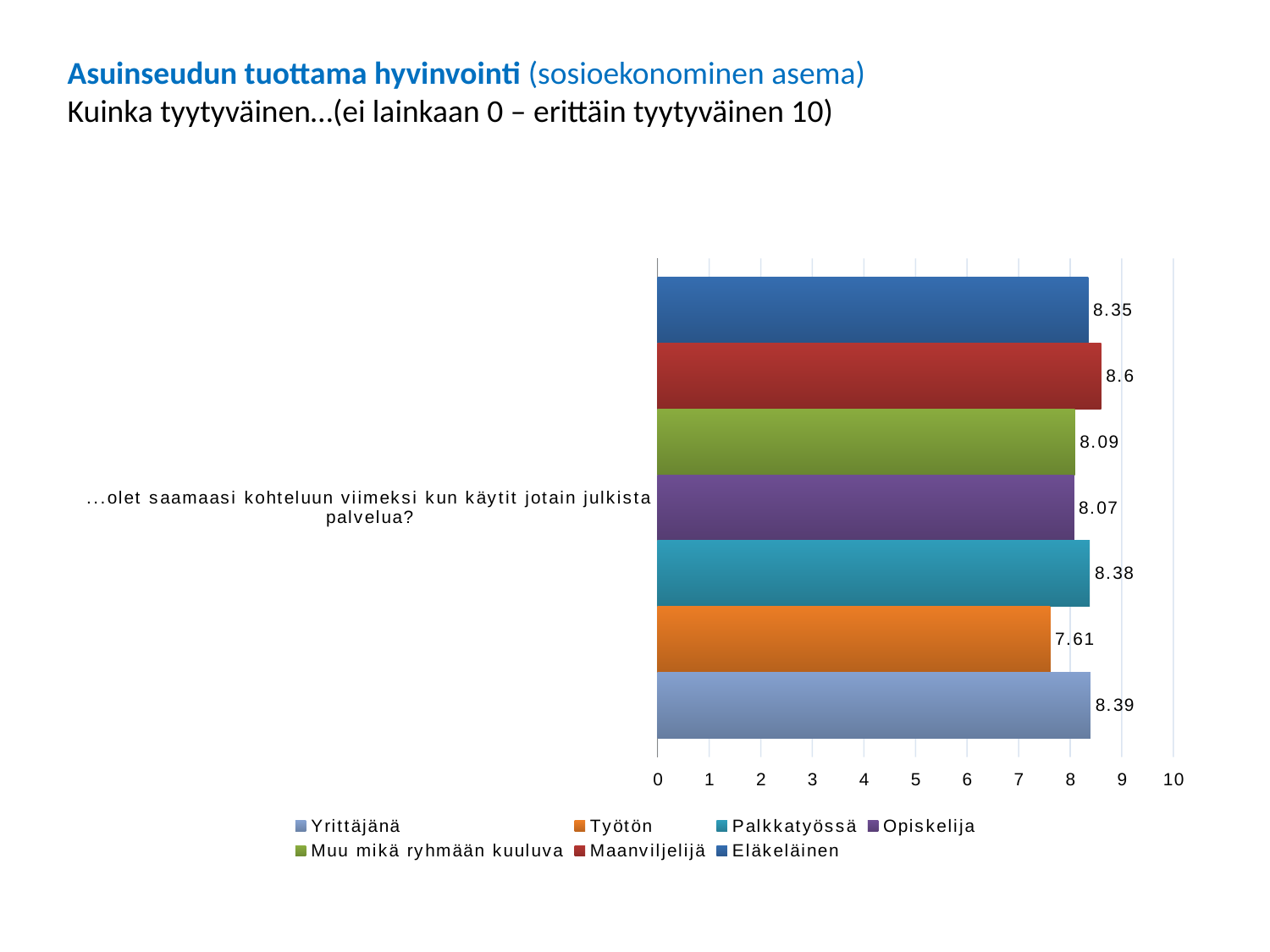
What is the value for Maanviljelijä? 8.6 What is the value for Työtön? 7.61 What is the value for Opiskelija? 8.07 Is the value for Työtön greater or less than 8? less Which is larger, the value for Eläkeläinen or the value for Opiskelija? Eläkeläinen What is the difference between the values for Maanviljelijä and Työtön? 0.99 Which group has the lowest value? Työtön Which group has the highest value? Maanviljelijä What colour is the bar for Työtön? orange How many series does the legend list? 7 What is the value for Eläkeläinen? 8.35 What kind of chart is shown on the slide? bar chart